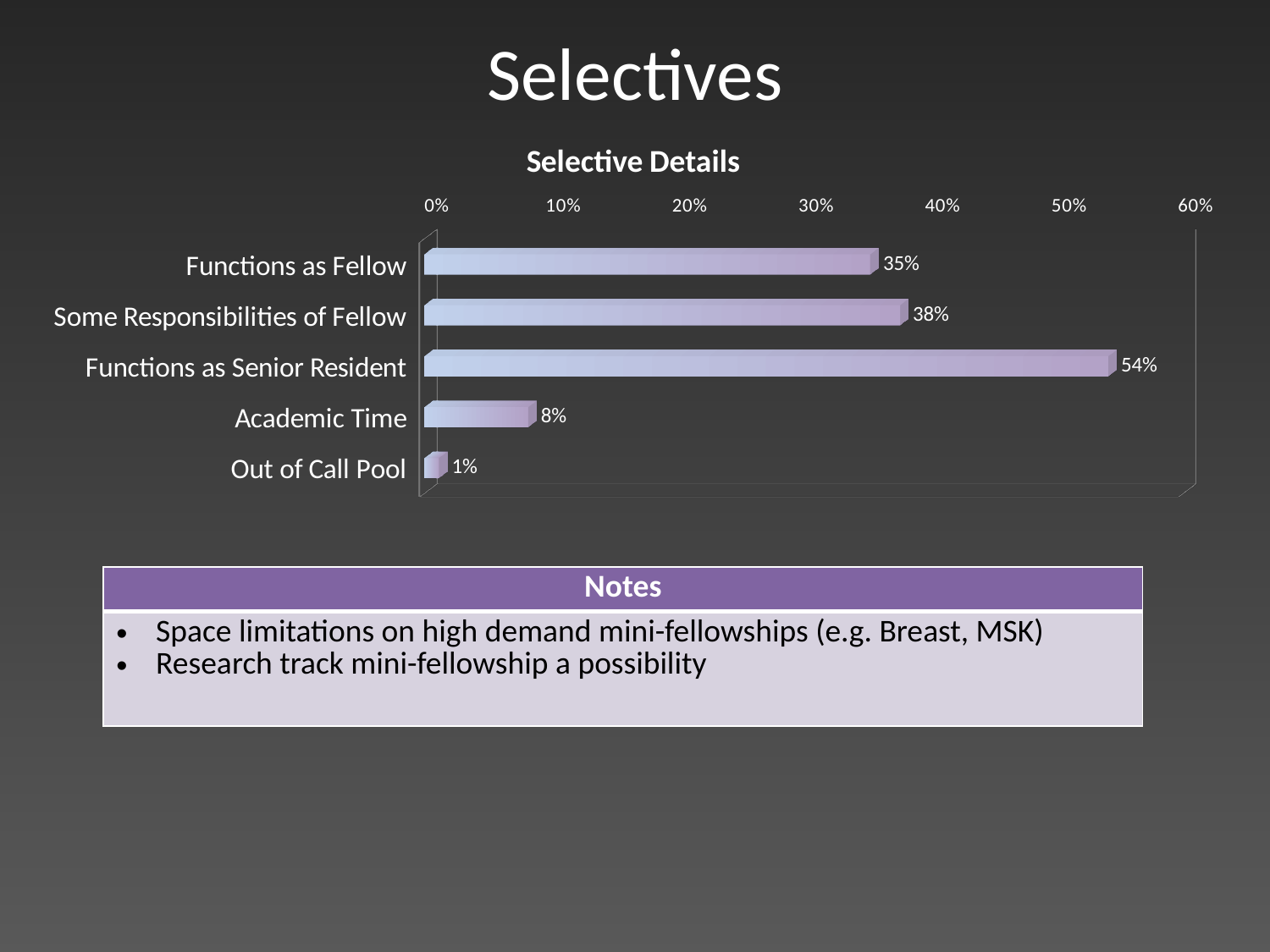
What is the difference between Functions as Senior Resident and Functions as Fellow? 19% What is the value for Out of Call Pool? 1% What is the value for Some Responsibilities of Fellow? 38% What is the value for Academic Time? 8% Which category has the lowest value? Out of Call Pool Which category has the highest value? Functions as Senior Resident Which is larger, Some Responsibilities of Fellow or Functions as Fellow? Some Responsibilities of Fellow How many categories are shown in the chart? 5 What is the difference between Academic Time and Out of Call Pool? 7% Is the value for Functions as Senior Resident greater or less than 50%? greater What is the value for Functions as Fellow? 35% What kind of chart is shown on the slide? Bar chart